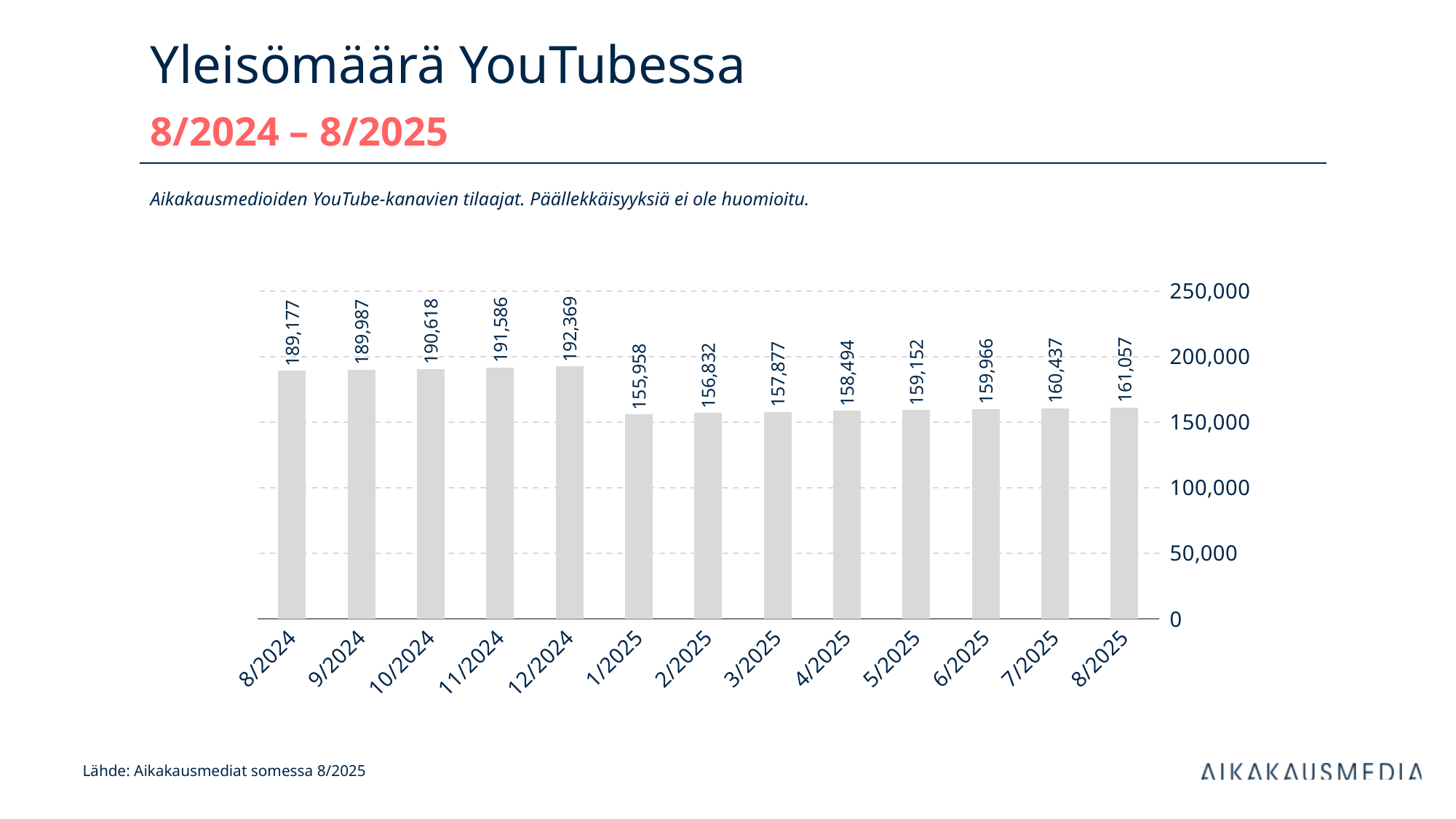
What is the value for 1/2025? 155,958 Which month has the lowest value? 1/2025 What is the value for 8/2025? 161,057 Is the value for 11/2024 greater or less than 150,000? greater What is the difference between the values for 12/2024 and 1/2025? 36,411 Do the values rise or fall from 1/2025 to 8/2025? rise What is the title of the chart on the slide? Yleisömäärä YouTubessa Which month has the highest value? 12/2024 How many months are shown on the x axis? 13 What is the value for 12/2024? 192,369 Which is larger, the value for 8/2024 or the value for 8/2025? 8/2024 What kind of chart is shown on the slide? bar chart